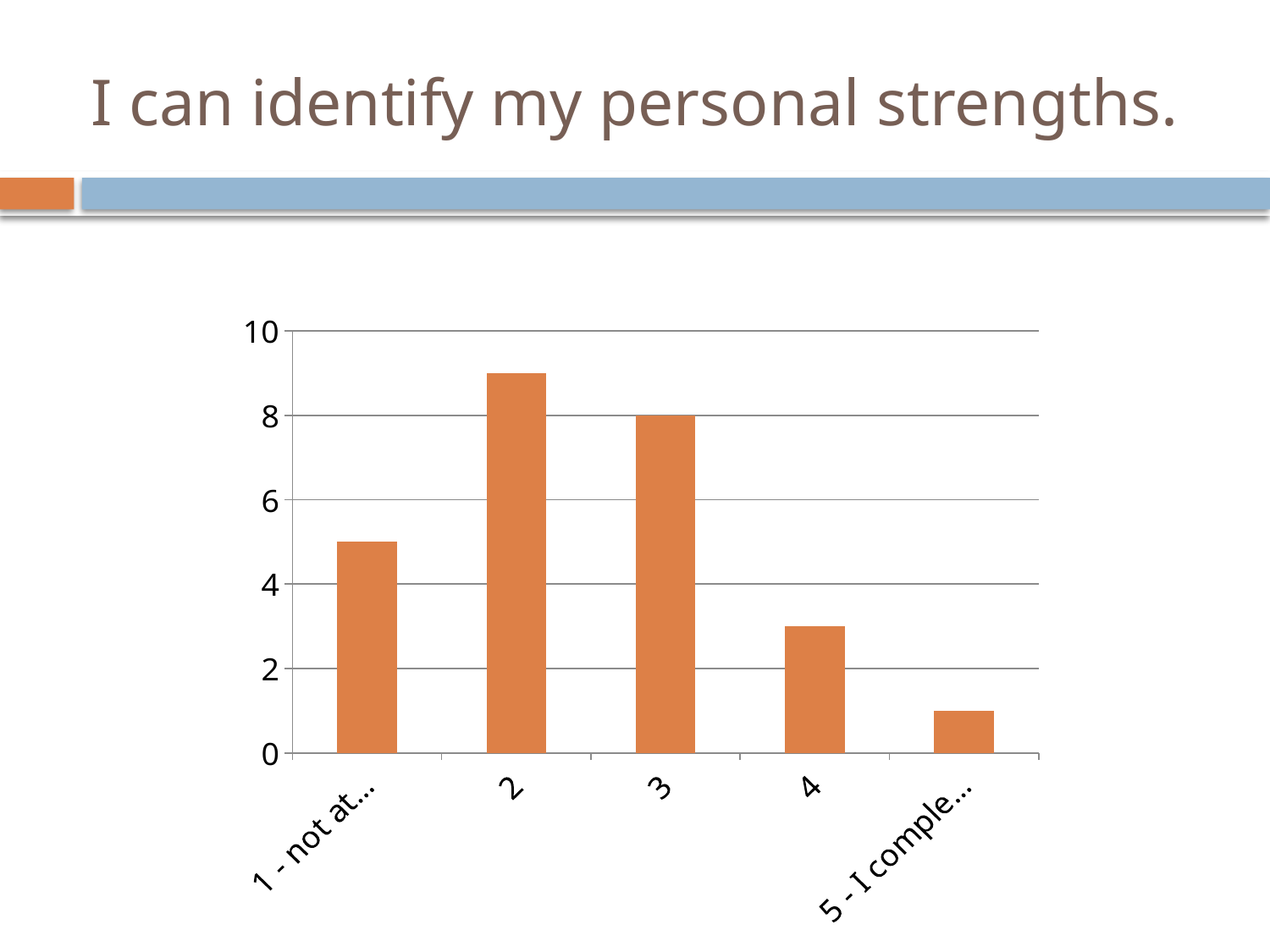
How many categories are plotted on the x axis? 5 What kind of chart is shown on the slide? bar chart Is the value for the first category (1 - not at...) greater or less than 4? greater Is the value for category 2 greater or less than 8? greater Which is larger, the value for category 2 or the value for category 3? 2 Which is larger, the value for the first category (1 - not at...) or the value for category 4? 1 - not at... What is the value for category 3? 8 Which category has the lowest bar? 5 - I comple... Which category has the highest bar? 2 Do the values rise or fall from category 3 to the last category? fall Is the value for the last category (5 - I comple...) greater or less than 2? less